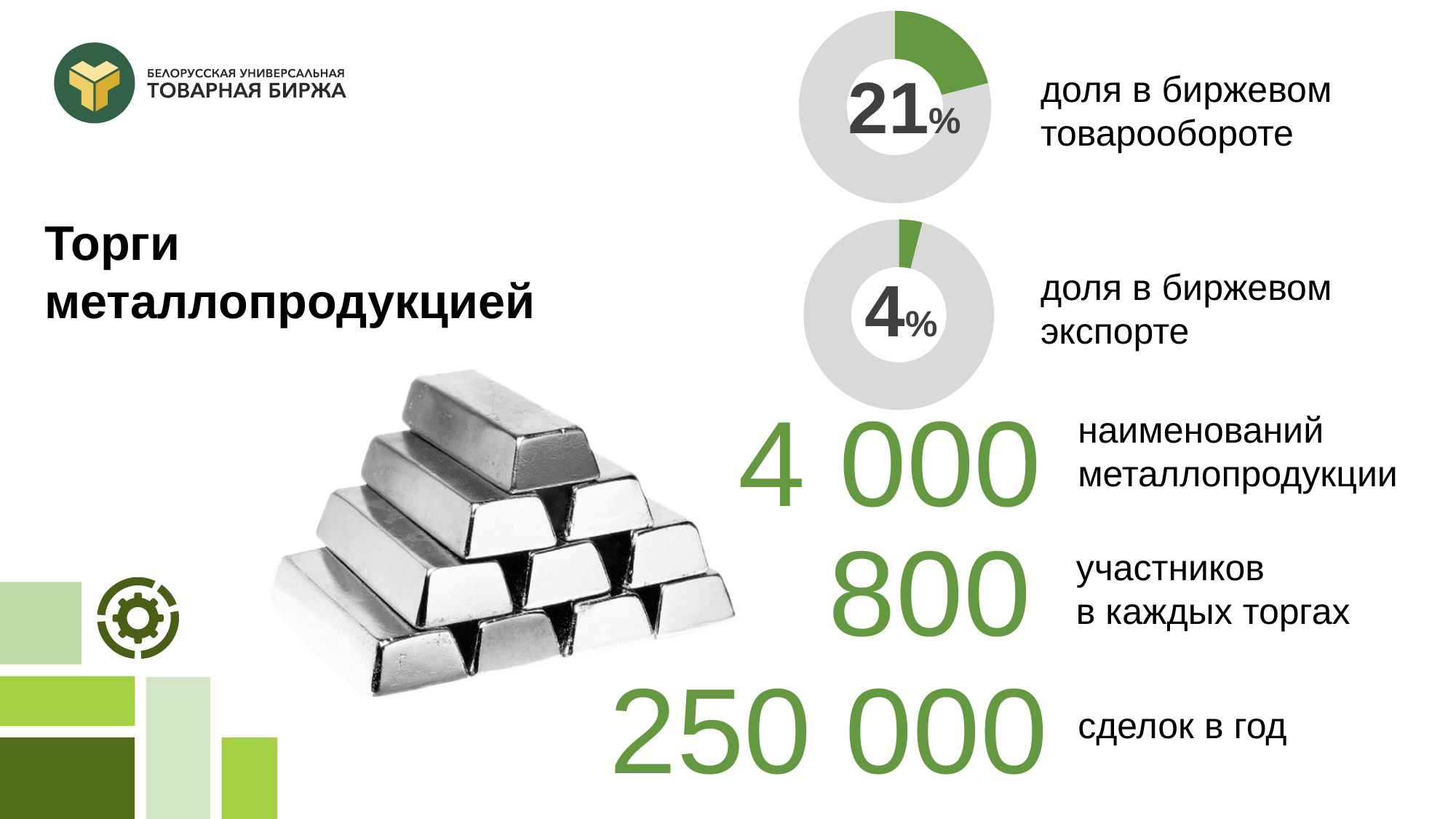
What colour is the highlighted slice in both donut charts? Green In the bottom donut chart, what share of the ring is grey (not green)? 96% How many donut charts are shown on the slide? 2 Which of the two donut charts shows the smaller value? The share in exchange exports (4%) On the bottom donut chart, what share of exchange exports (доля в биржевом экспорте) does metal products trading account for? 4% What kind of chart is used to show the share in exchange turnover at the top right of the slide? Donut (pie) chart Which is larger: the share in exchange turnover or the share in exchange exports? Share in exchange turnover (21%) In the top donut chart, what share of the ring is grey (not green)? 79% Which of the two donut charts shows the larger value? The share in exchange turnover (21%) What is the title of the slide that contains the two donut charts? Торги металлопродукцией By how many percentage points does the share in exchange turnover exceed the share in exchange exports? 17 percentage points On the top donut chart, what share of exchange turnover (доля в биржевом товарообороте) does metal products trading account for? 21%